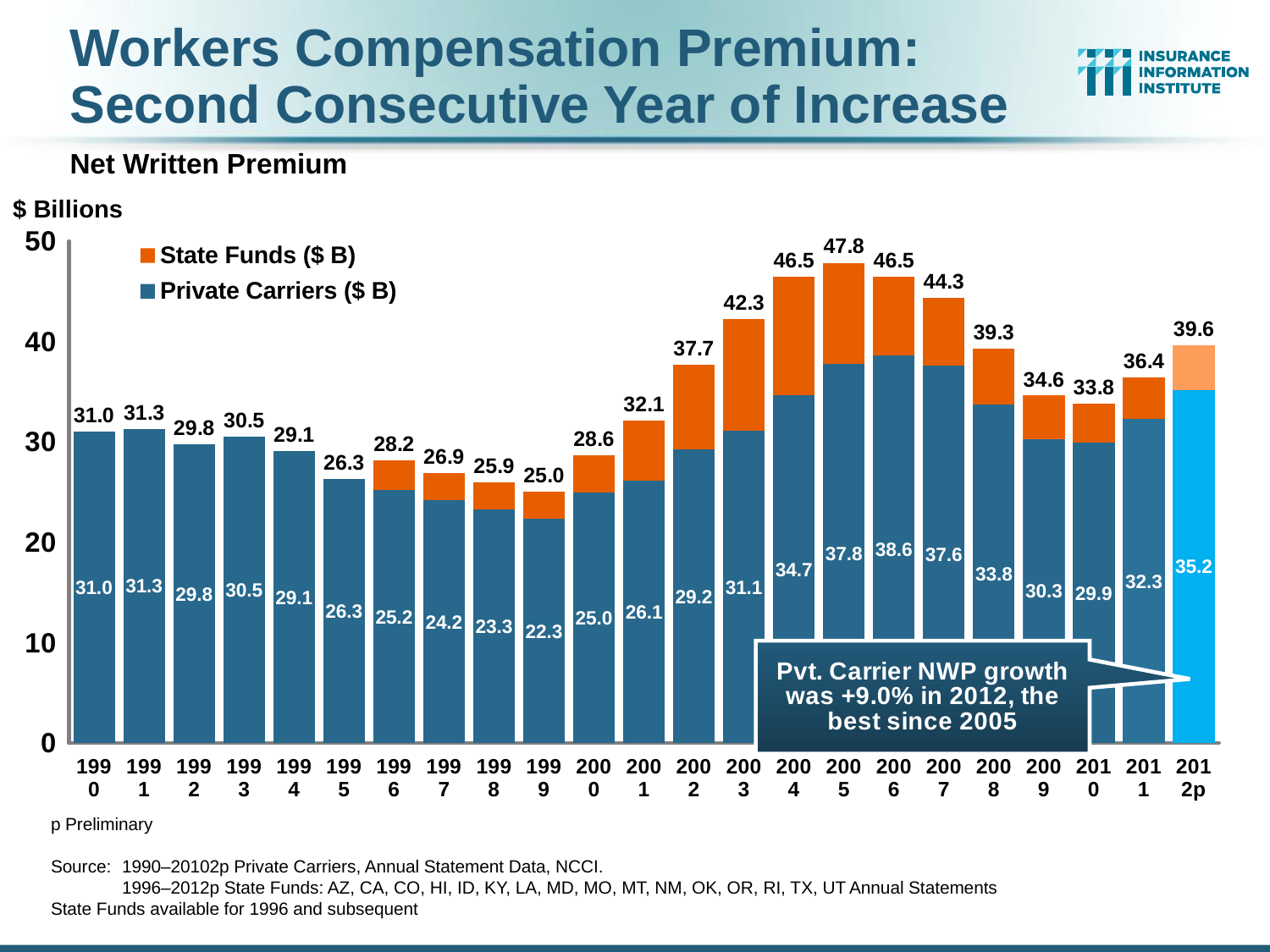
What kind of chart is shown on the slide? bar chart What is the difference between the total for 2012p and the total for 2011? 3.2 How many series does the legend list? 2 Which year has the larger total net written premium, 2003 or 2007? 2007 What is the Private Carriers value for 2012p? 35.2 How many years are shown on the x axis? 23 What is the total net written premium for 2005? 47.8 What is the Private Carriers value for 2006? 38.6 Which year has the highest total net written premium? 2005 By how much does the total for 2005 exceed the Private Carriers value for 2005? 10.0 Do the total values rise or fall from 1999 to 2005? rise Which year has the lowest total net written premium? 1999